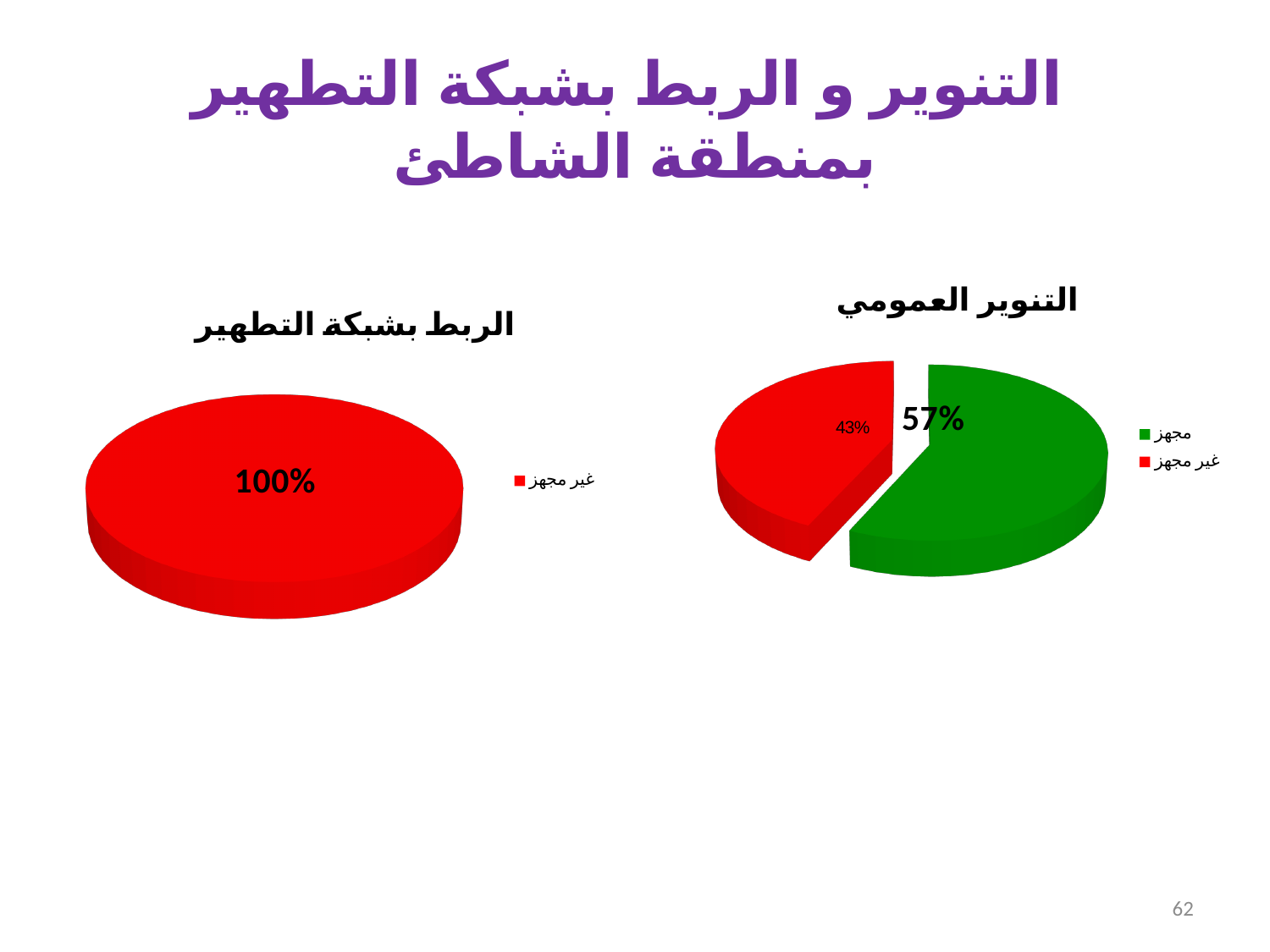
How many slices does the chart titled "الربط بشبكة التطهير" have? 1 In the chart titled "التنوير العمومي", what share is labelled for "غير مجهز"? 43% How many slices does the chart titled "التنوير العمومي" have? 2 In the chart titled "التنوير العمومي", what colour is the slice for "مجهز"? Green What kind of chart is the chart titled "الربط بشبكة التطهير"? Pie chart How many entries does the legend of the chart titled "التنوير العمومي" list? 2 In the chart titled "الربط بشبكة التطهير", what share is labelled for "غير مجهز"? 100% In the chart titled "التنوير العمومي", which is larger: the share of "مجهز" or the share of "غير مجهز"? مجهز In the chart titled "التنوير العمومي", what is the difference between the shares of "مجهز" and "غير مجهز"? 14% In the chart titled "التنوير العمومي", which category has the smallest slice? غير مجهز In the chart titled "التنوير العمومي", which category has the largest slice? مجهز In the chart titled "التنوير العمومي", what share is labelled for "مجهز"? 57%